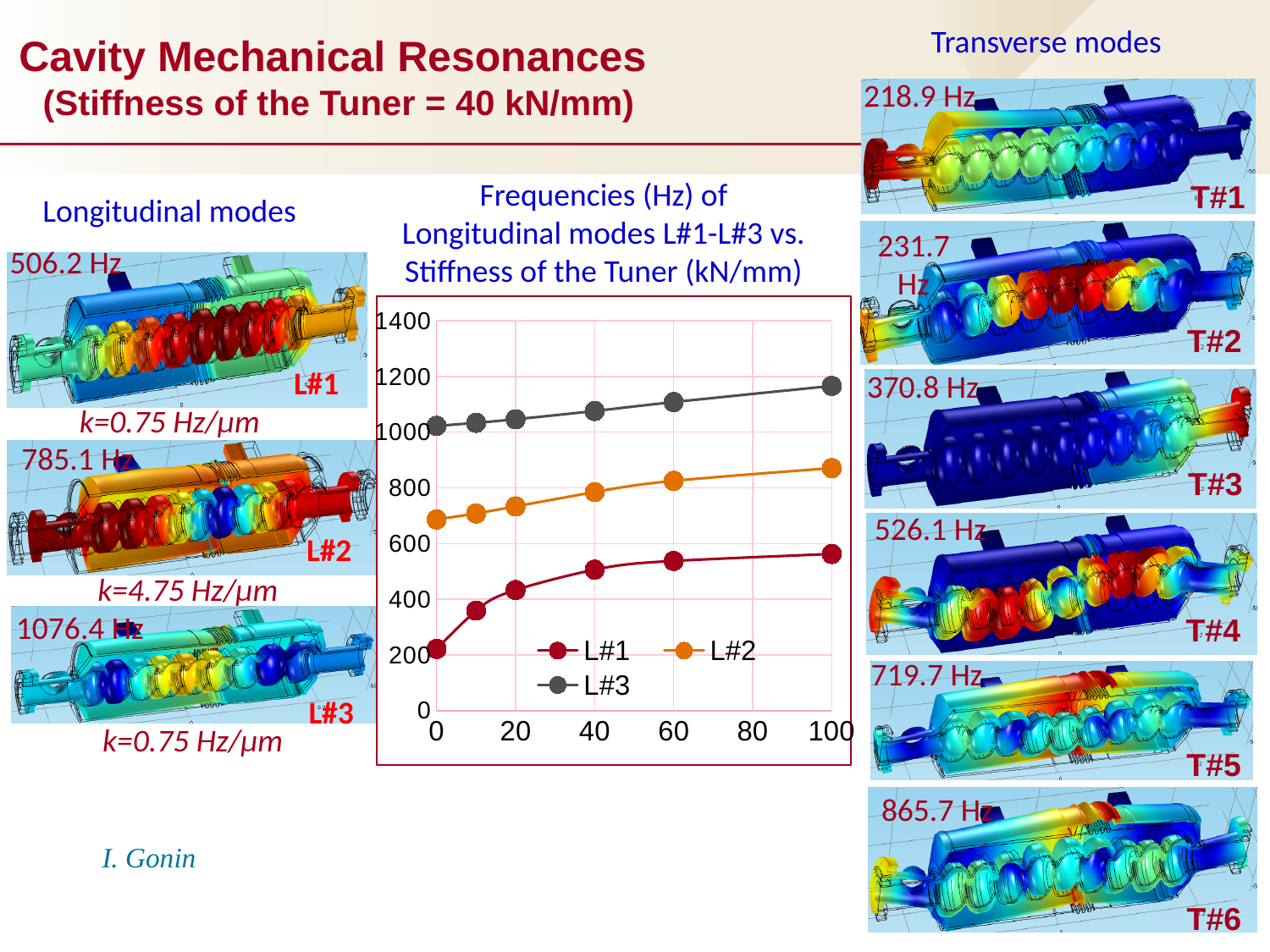
Which series are listed in the chart legend? L#1, L#2, L#3 What kind of chart is shown on the slide? line chart How many data points are plotted for the L#1 series? 6 How many series does the chart legend list? 3 Does the frequency of L#1 rise or fall as the stiffness of the tuner increases? rise Which series has the highest frequency values across the whole stiffness range? L#3 Is the frequency of L#3 at a stiffness of 100 greater or less than 1000? greater Is the frequency of L#2 at a stiffness of 100 greater or less than 800? greater What is the title of the chart? Frequencies (Hz) of Longitudinal modes L#1-L#3 vs. Stiffness of the Tuner (kN/mm) Is the frequency of L#1 at a stiffness of 0 greater or less than 400? less Which series has the lowest frequency values across the whole stiffness range? L#1 At a stiffness of 100 kN/mm, which series has the larger frequency, L#2 or L#3? L#3